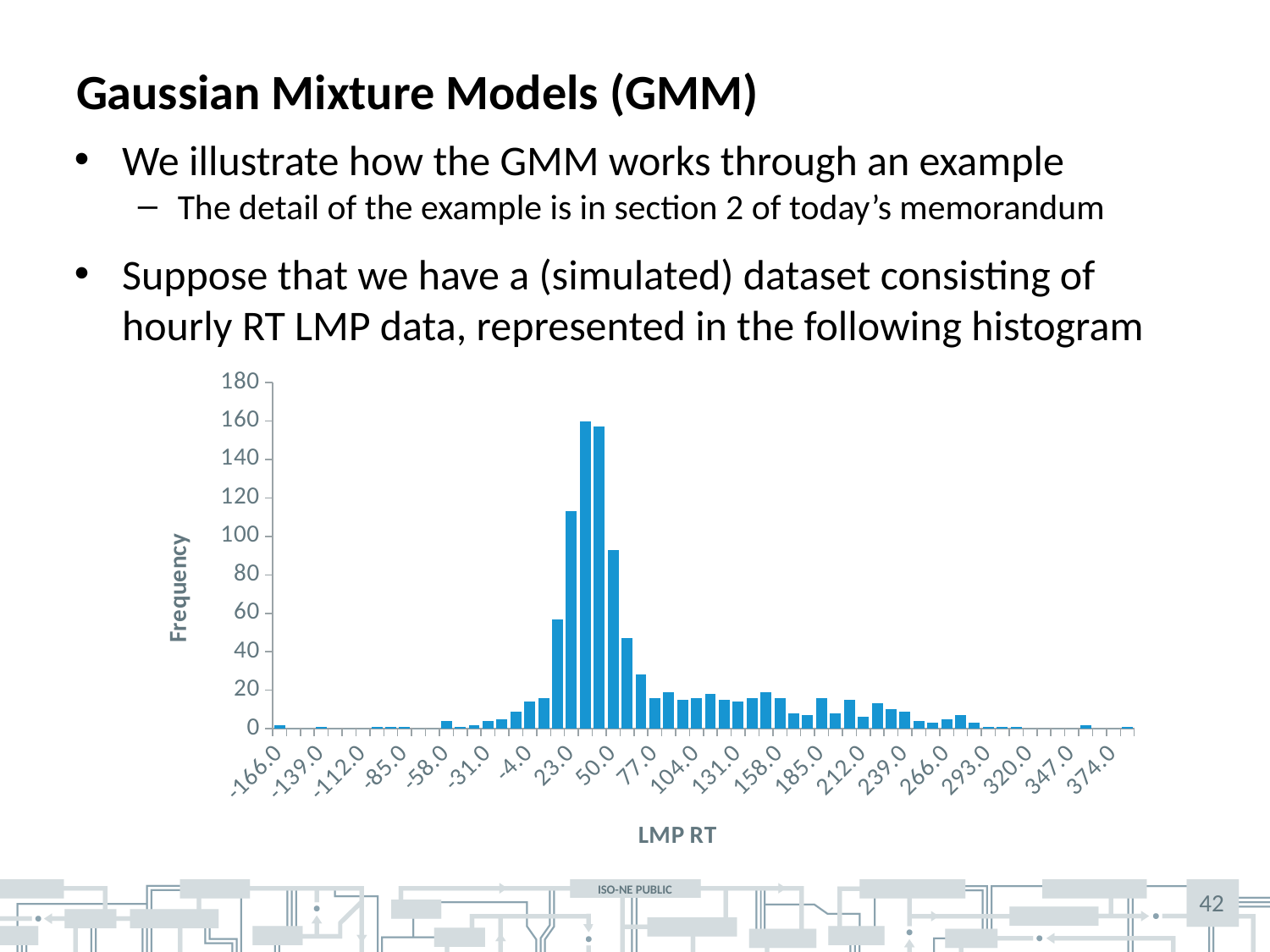
How many labelled tick values are shown along the horizontal axis? 21 Which region of the horizontal axis contains the tallest bars: around 23.0 to 50.0 or around 239.0 to 266.0? around 23.0 to 50.0 What is the highest tick value shown on the vertical axis? 180 Is the frequency of the bar at 104.0 greater or less than 40? less Is the frequency of the tallest bar greater or less than 140? greater Do the frequencies generally rise or fall as LMP RT moves from -58.0 to 23.0? rise Do the frequencies generally rise or fall as LMP RT moves from 23.0 to 77.0? fall What is the title of the vertical axis of the histogram? Frequency What kind of chart is shown on the slide? bar chart (histogram) Is the frequency of the bar at -166.0 greater or less than 20? less What is the title of the horizontal axis of the histogram? LMP RT